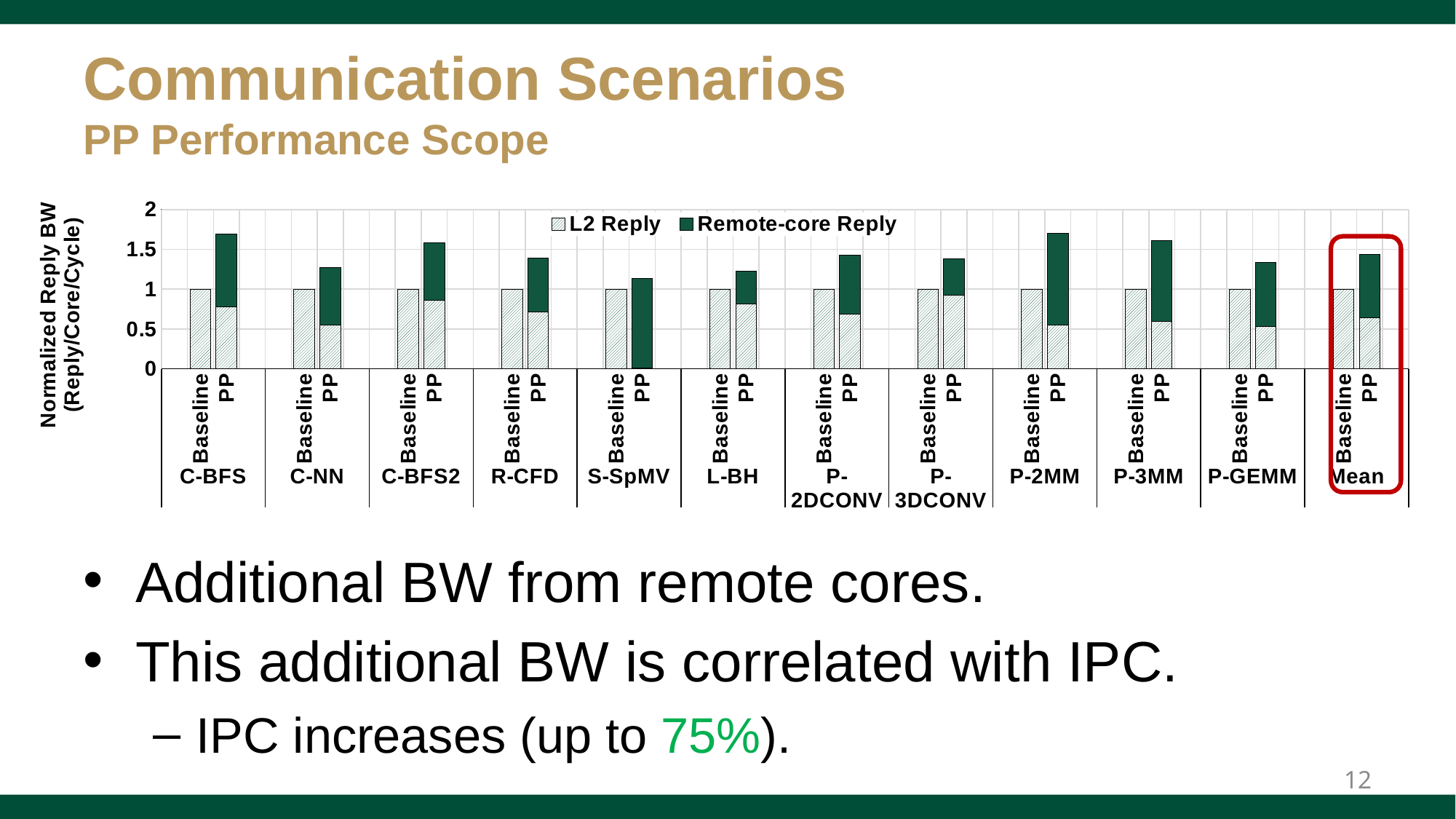
Which benchmark group on the x axis is highlighted with a red box? Mean Is the total height of the PP bar for C-BFS greater or less than 1.5? greater What is the normalized reply BW value of the Baseline bar for C-BFS? 1 Is the total height of the PP bar for Mean greater or less than 1? greater Which has the taller PP bar, P-2MM or L-BH? P-2MM Is the total height of the PP bar for P-2MM greater or less than 1.5? greater Which has the taller PP bar, C-BFS or S-SpMV? C-BFS What kind of chart is shown on the slide? Stacked bar chart How many series does the chart legend list? 2 How many benchmark groups (including Mean) are shown along the x axis? 12 What are the two series named in the chart legend? L2 Reply and Remote-core Reply